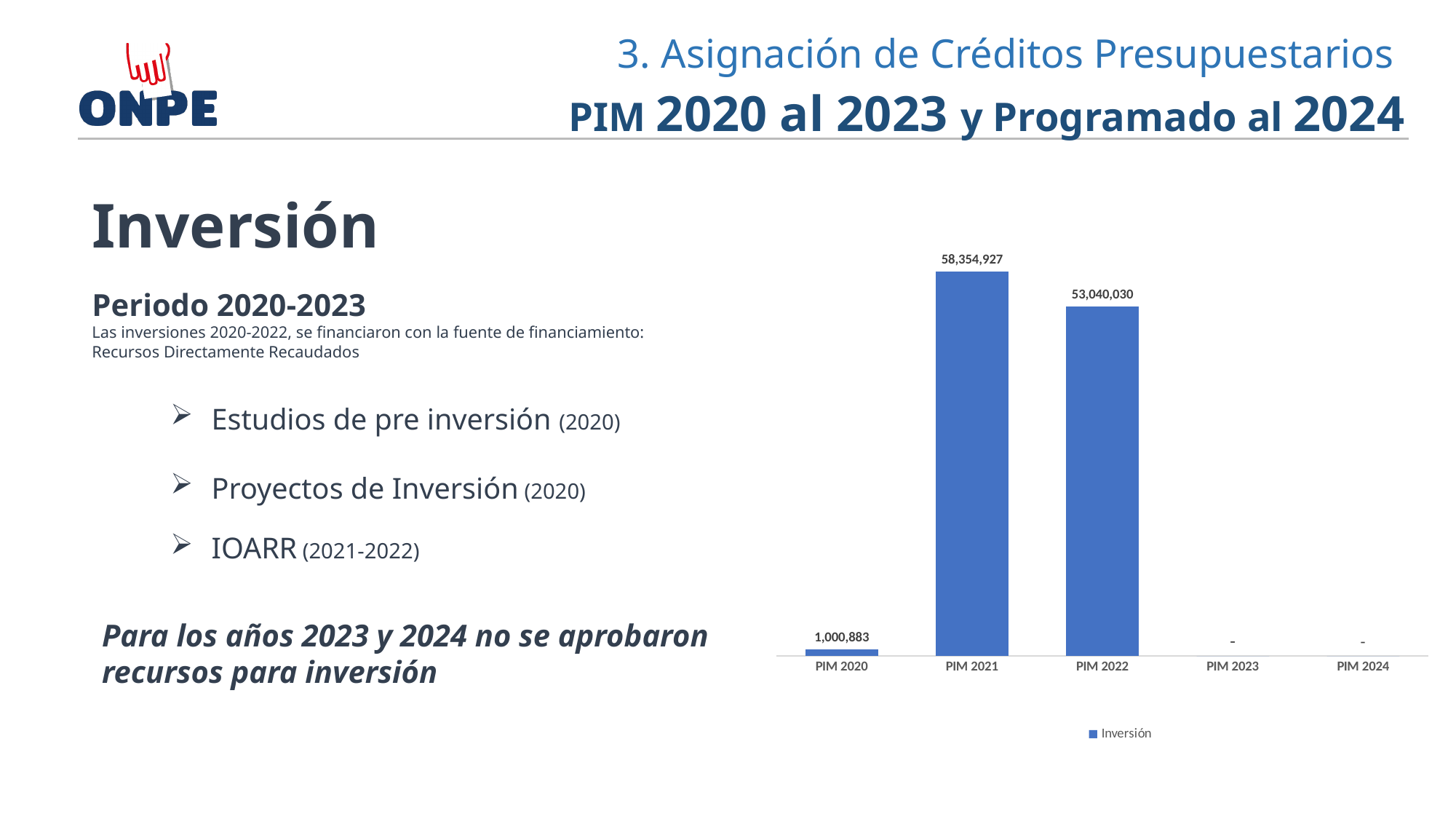
What is the difference between the values for PIM 2021 and PIM 2022? 5,314,897 What is the value for PIM 2021? 58,354,927 What is the name of the series in the legend? Inversión What is the value for PIM 2020? 1,000,883 How many categories are shown on the x axis? 5 What is the value for PIM 2022? 53,040,030 Which is larger, the value for PIM 2021 or PIM 2022? PIM 2021 Which category has the highest value? PIM 2021 What is the difference between the values for PIM 2022 and PIM 2020? 52,039,147 What is shown as the value for PIM 2023? - How many series does the legend list? 1 What kind of chart is shown? bar chart